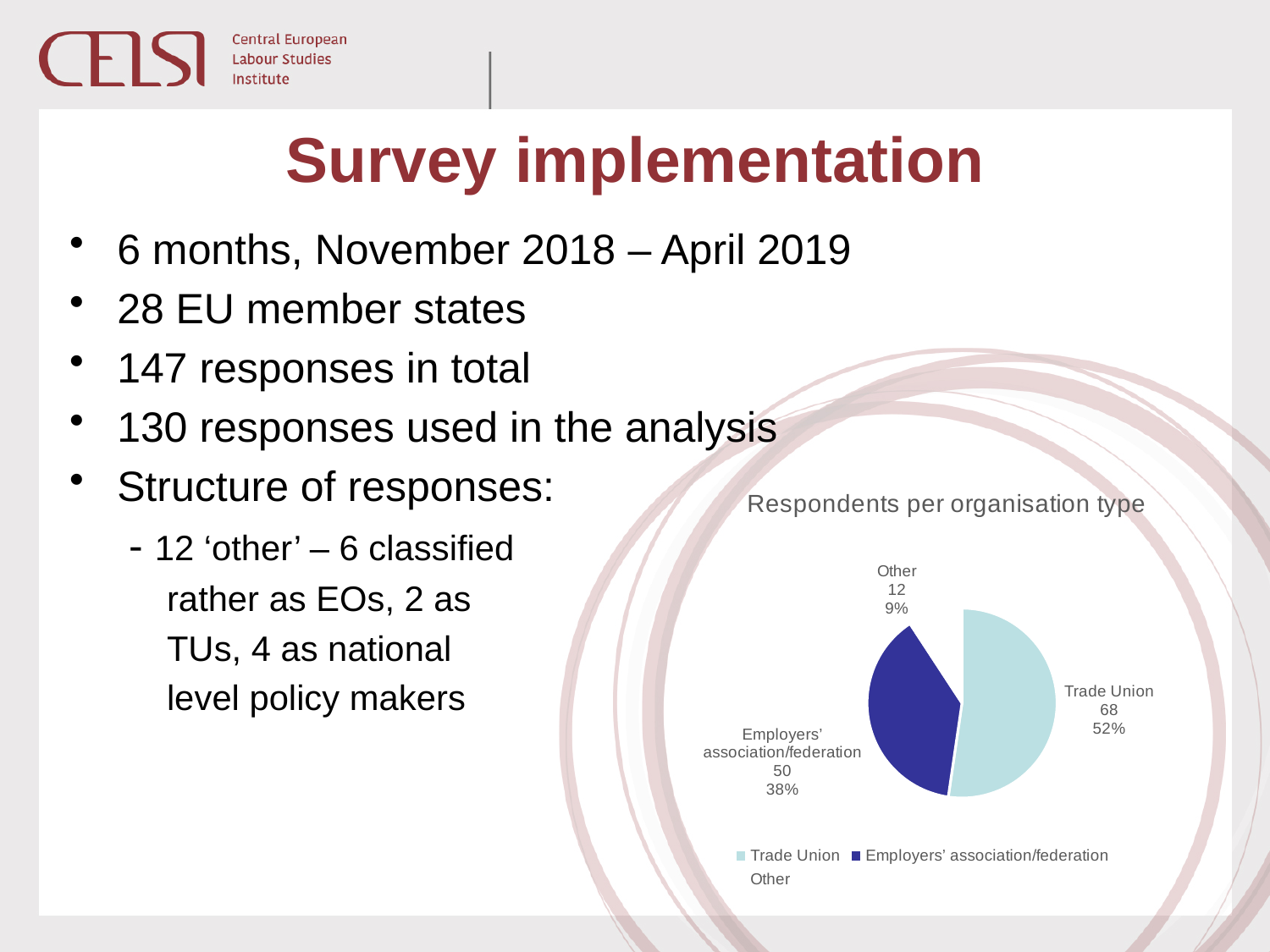
Which organisation type has the most respondents? Trade Union How many respondents are Trade Unions according to the chart? 68 What is the difference in the number of respondents between Trade Union and Employers' association/federation? 18 What is the title of the chart? Respondents per organisation type What share of the pie does Trade Union represent? 52% Which organisation type has the fewest respondents? Other What is the total number of respondents across all three slices of the pie chart? 130 How many respondents are Employers' association/federation according to the chart? 50 How many organisation types are shown in the pie chart? 3 What percentage of respondents are classified as Other? 9% What type of chart is shown on the slide? Pie chart Which has more respondents, Employers' association/federation or Other? Employers' association/federation